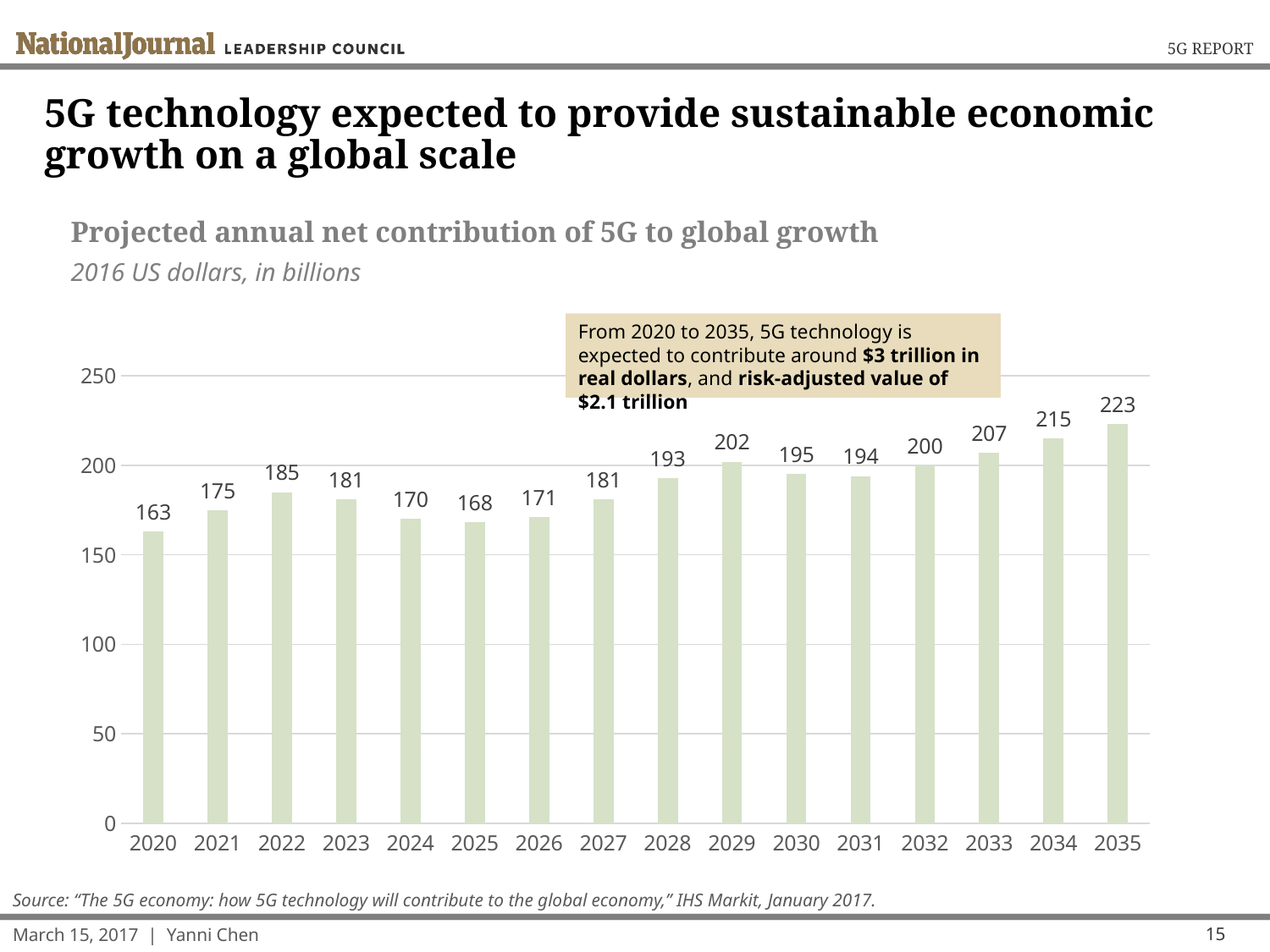
Which year has the lowest projected contribution? 2020 What is the projected value for 2029? 202 What is the projected value for 2035? 223 How many years are shown on the x axis? 16 Do the projected values generally rise or fall from 2027 to 2035? Rise What is the difference between the projected values for 2035 and 2020? 60 Which year has the highest projected contribution? 2035 What kind of chart is shown on the slide? Bar chart What is the projected annual net contribution of 5G to global growth in 2020? 163 In what units are the chart values expressed? 2016 US dollars, in billions Is the value for 2032 greater or less than 150? greater Which year has a larger projected value, 2022 or 2025? 2022